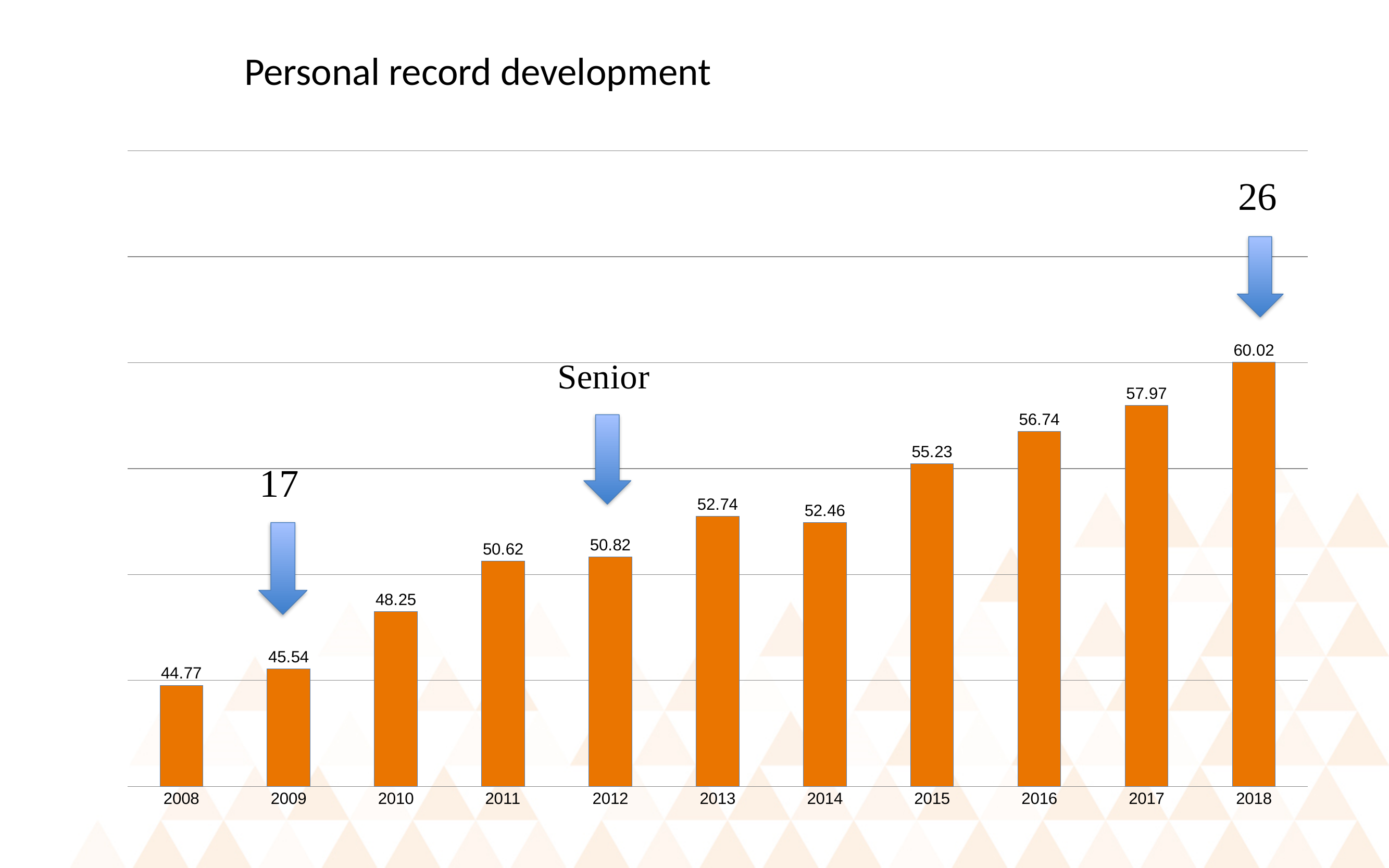
What kind of chart is this? bar chart Which year has the lowest value? 2008 What is the title of the chart? Personal record development Which is larger, the value for 2010 or the value for 2011? 2011 Do the values generally rise or fall from 2008 to 2018? rise How many years are shown on the x axis? 11 What is the difference between the values for 2013 and 2014? 0.28 What is the value for 2018? 60.02 What is the difference between the values for 2018 and 2008? 15.25 What is the value for 2014? 52.46 Which year has the highest value? 2018 What is the value for 2008? 44.77